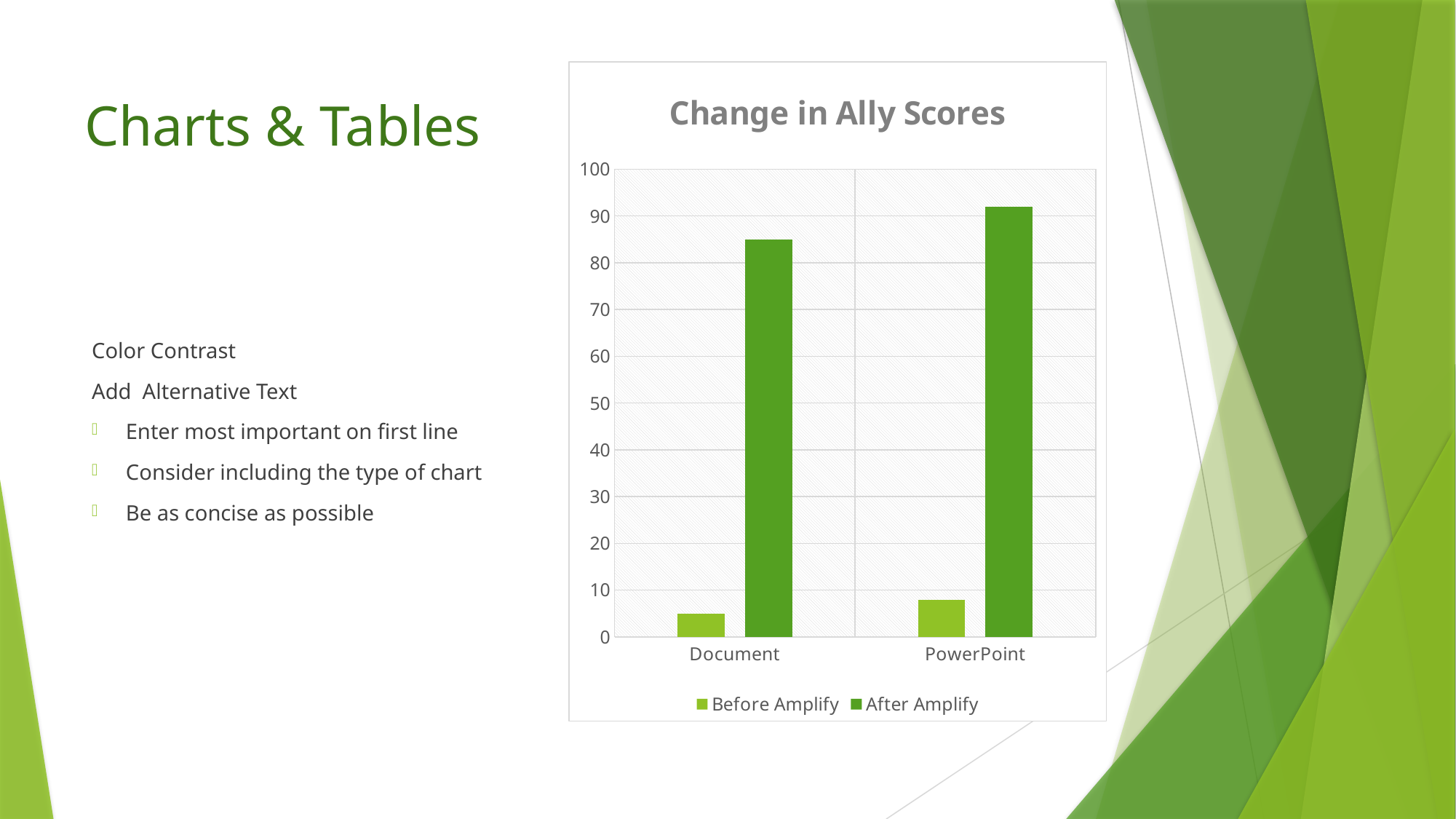
Which category has the lowest Before Amplify value? Document How many categories are shown on the x axis of the chart? 2 Which series is shown in the darker green colour in the chart? After Amplify What kind of chart is shown on the slide? bar chart What is the title of the chart? Change in Ally Scores Is the After Amplify value for Document greater or less than 80? greater Which category has the higher After Amplify value, Document or PowerPoint? PowerPoint Is the Before Amplify value for PowerPoint greater or less than 10? less Is the Before Amplify value for Document greater or less than 10? less How many series does the chart legend list? 2